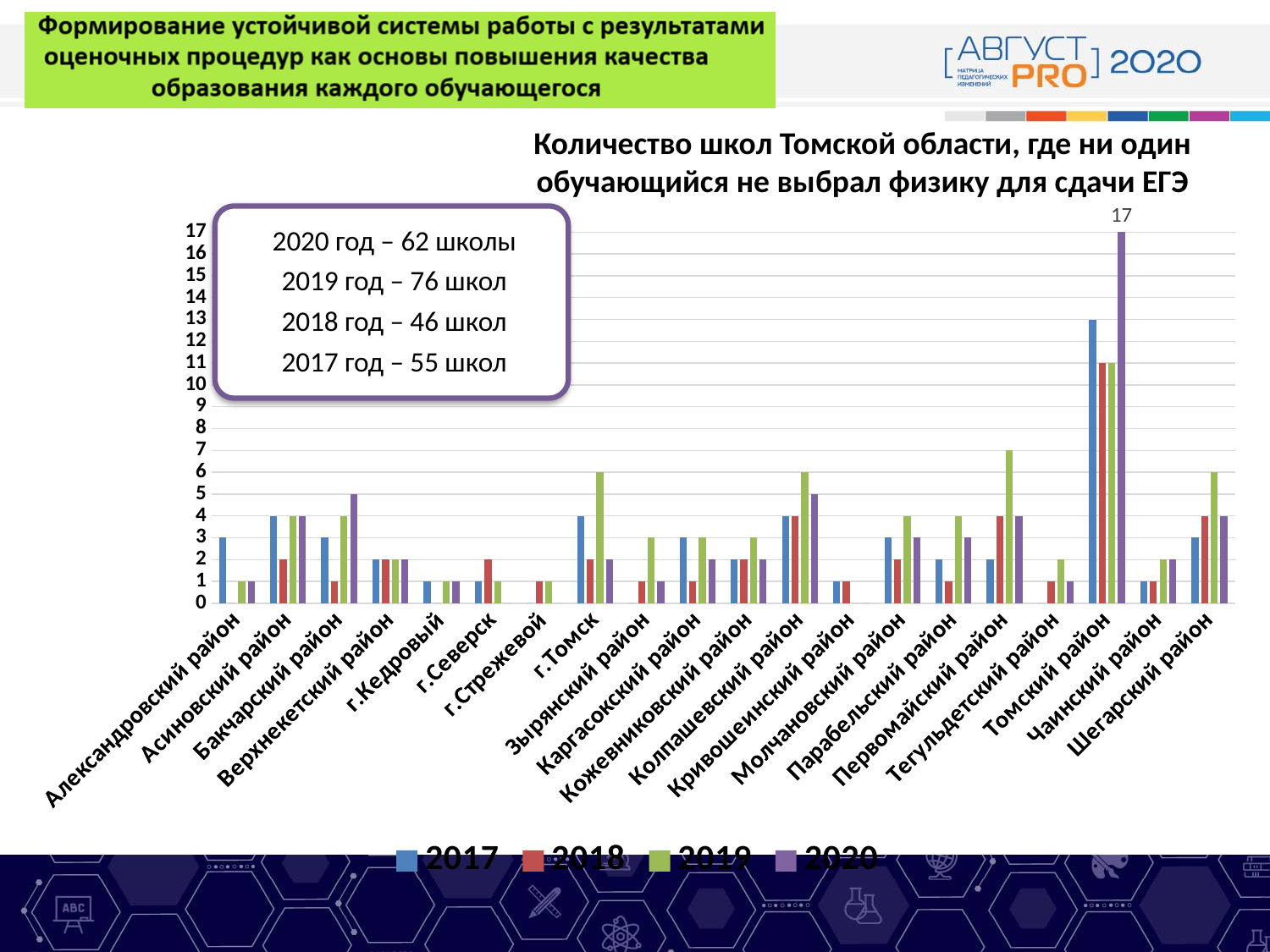
What is the value for Томский район in 2020? 17 Is the value for Первомайский район in 2019 greater or less than 5? greater What is the title of the chart? Количество школ Томской области, где ни один обучающийся не выбрал физику для сдачи ЕГЭ How many districts (categories) are shown on the x axis? 20 Which district has the highest value in the 2020 series? Томский район For г.Томск, which series has the larger value: 2017 or 2019? 2019 What are the legend entries of the chart? 2017, 2018, 2019, 2020 Is the value for Томский район in 2018 greater or less than 5? greater Is the value for Томский район in 2017 greater or less than 10? greater How many series does the legend list? 4 What kind of chart is shown on the slide? bar chart For Бакчарский район, which series has the larger value: 2018 or 2020? 2020